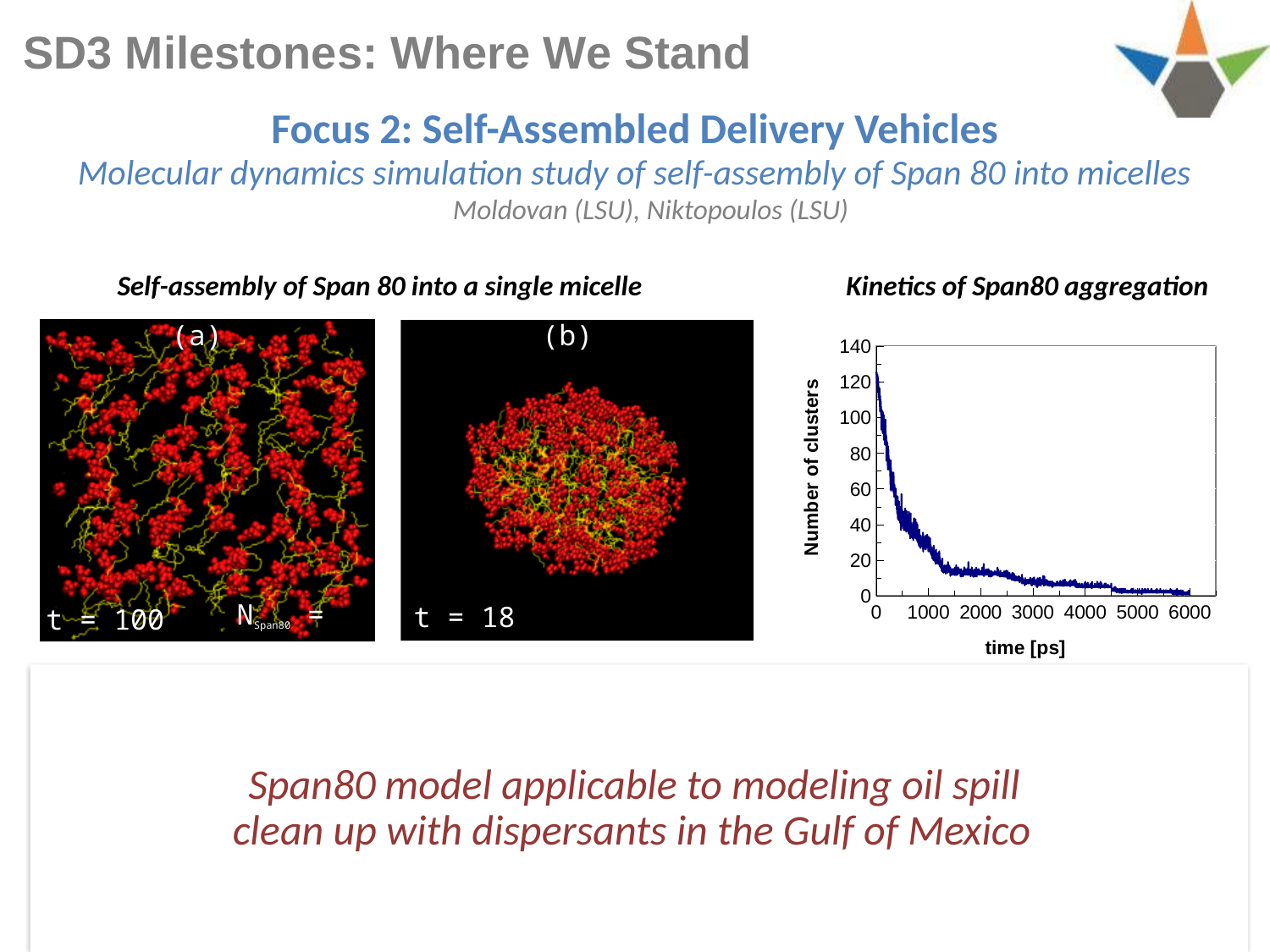
In the 'Kinetics of Span80 aggregation' chart, is the number of clusters at 3000 ps greater or less than 40? less What is the label of the x-axis in the 'Kinetics of Span80 aggregation' chart? time [ps] In the 'Kinetics of Span80 aggregation' chart, is the number of clusters higher at 0 ps or at 5000 ps? 0 ps What is the label of the y-axis in the 'Kinetics of Span80 aggregation' chart? Number of clusters In the 'Kinetics of Span80 aggregation' chart, is the number of clusters at 1000 ps greater or less than 60? less In the 'Kinetics of Span80 aggregation' chart, is the number of clusters at time 0 greater or less than 100? greater In the 'Kinetics of Span80 aggregation' chart, does the number of clusters rise or fall as time increases? fall What kind of chart is the 'Kinetics of Span80 aggregation' chart? line chart How many lines are plotted in the 'Kinetics of Span80 aggregation' chart? 1